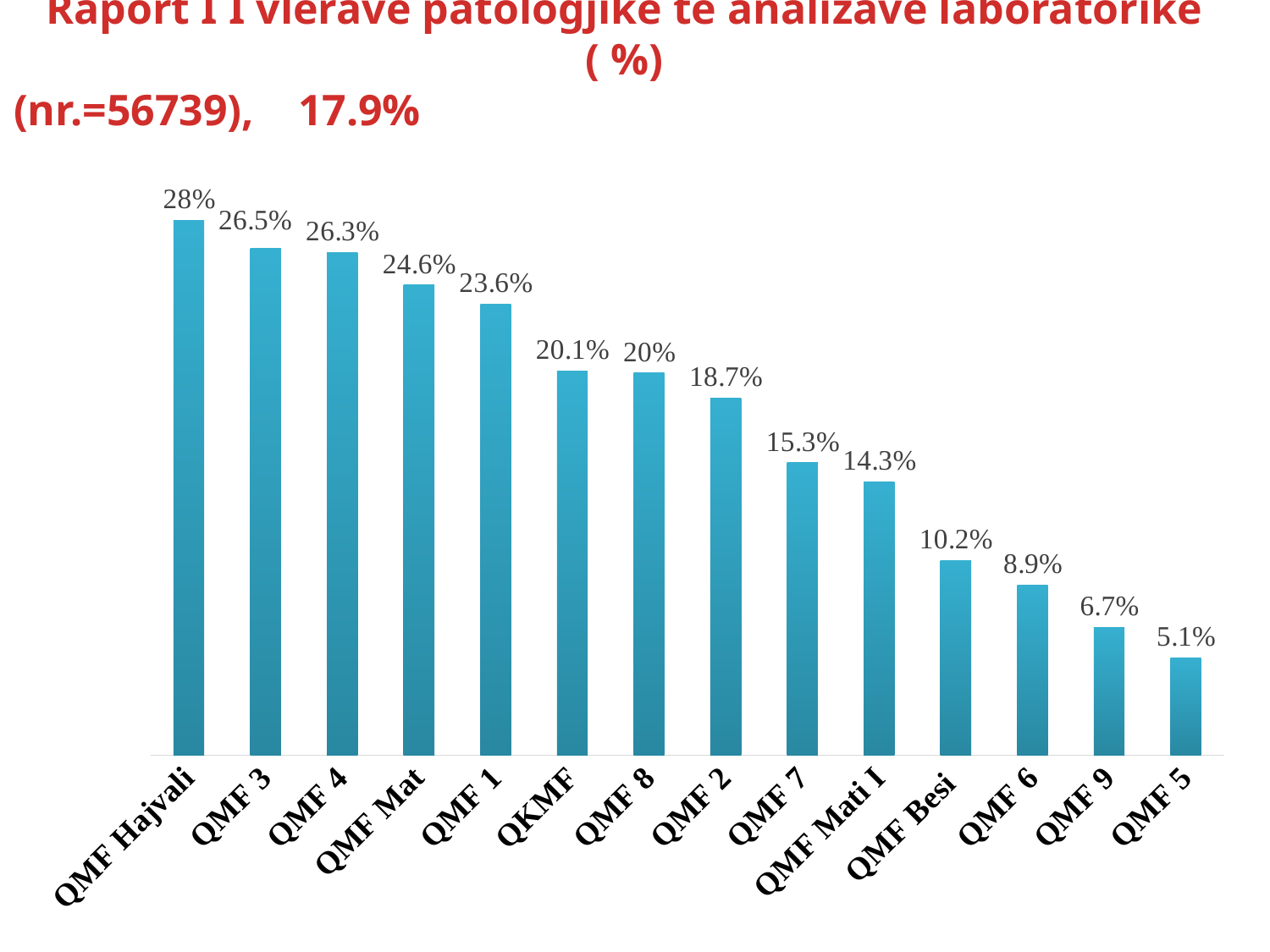
What is the difference between the values for QMF 3 and QMF 5? 21.4% What is the value for QMF Besi? 10.2% Which is larger, the value for QMF 2 or the value for QMF 6? QMF 2 Do the values rise or fall from left to right along the x axis? Fall What is the value for QKMF? 20.1% What is the value for QMF Hajvali? 28% What kind of chart is shown on the slide? Bar chart What is the value for QMF Mat? 24.6% Which category has the highest value? QMF Hajvali Which category has the lowest value? QMF 5 What is the difference between the values for QMF 7 and QMF Mati I? 1% How many categories are shown on the x axis? 14